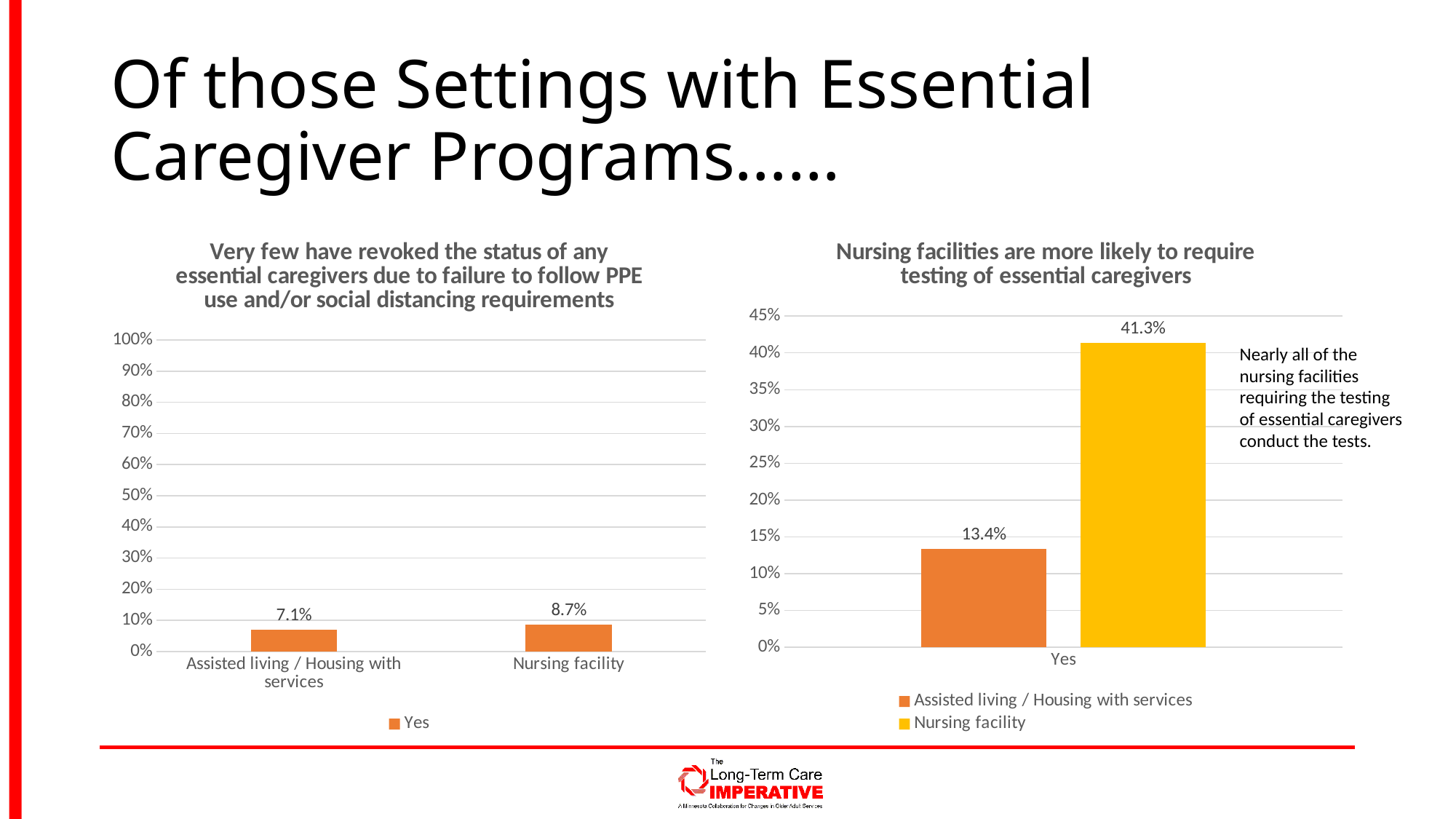
In the left chart, how many categories are shown on the x axis? 2 In the left chart, what is the value for Assisted living / Housing with services? 7.1% In the right chart, which series has the lower value? Assisted living / Housing with services In the left chart, which category has the higher value? Nursing facility In the right chart, how many series does the legend list? 2 In the right chart, what is the value for Nursing facility? 41.3% In the right chart, what is the value for Assisted living / Housing with services? 13.4% In the left chart, is the value for Nursing facility greater or less than 10%? less In the right chart, what is the difference between the Nursing facility value and the Assisted living / Housing with services value? 27.9% What type of chart is the right chart? Bar chart In the left chart, what is the difference between the Nursing facility value and the Assisted living / Housing with services value? 1.6% In the left chart, what is the value for Nursing facility? 8.7%